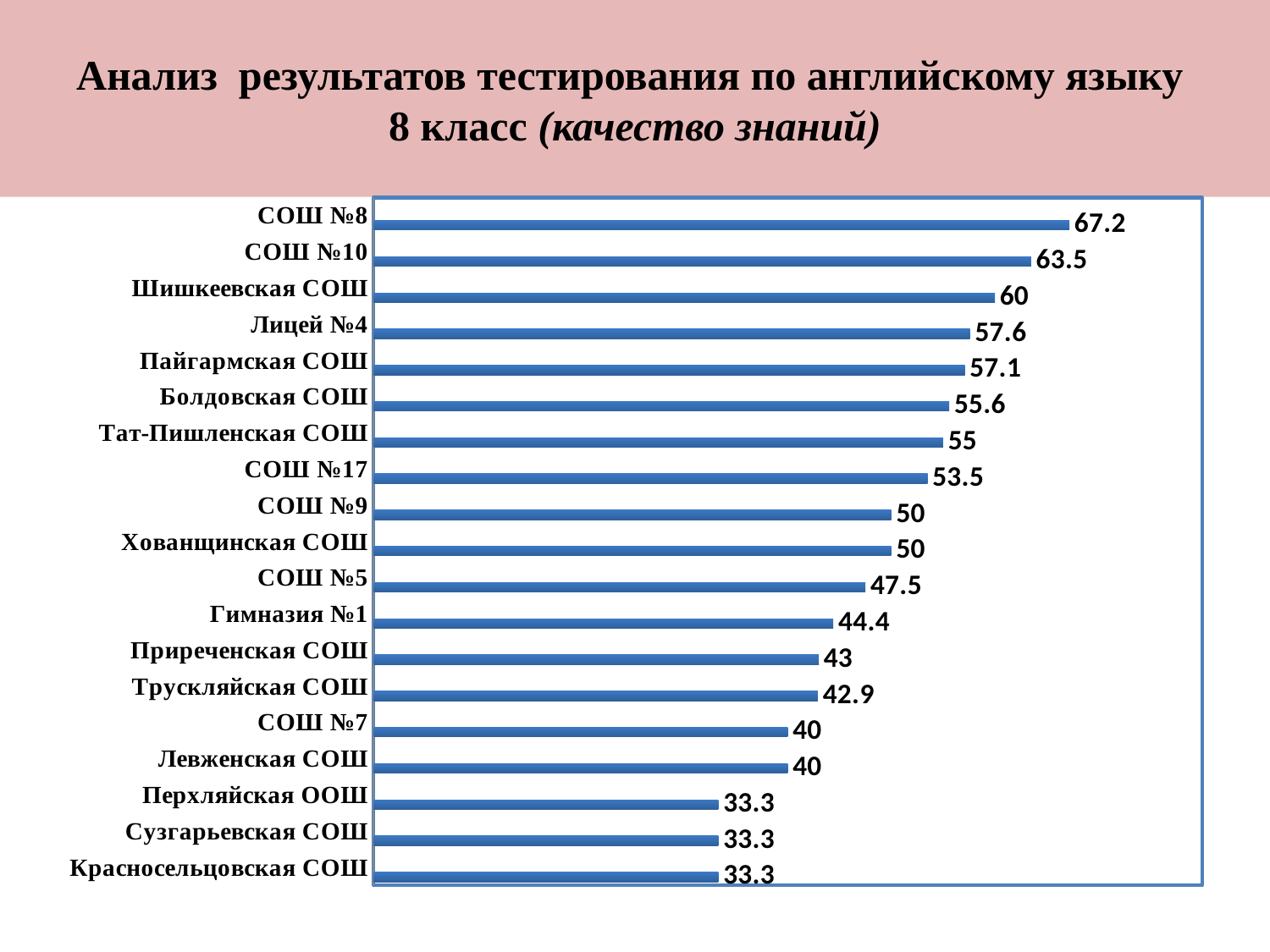
What is the difference between the values for СОШ №8 and СОШ №10? 3.7 What is the value for Перхляйская ООШ? 33.3 What type of chart is shown on the slide? Bar chart How many schools are shown in the chart? 19 What is the value for СОШ №10? 63.5 Which has a larger value, Лицей №4 or СОШ №17? Лицей №4 What is the difference between the values for Шишкеевская СОШ and Красносельцовская СОШ? 26.7 Which has a larger value, Приреченская СОШ or СОШ №7? Приреченская СОШ What is the value for Гимназия №1? 44.4 Which school has the highest value? СОШ №8 What is the value for Болдовская СОШ? 55.6 What is the value for Трускляйская СОШ? 42.9